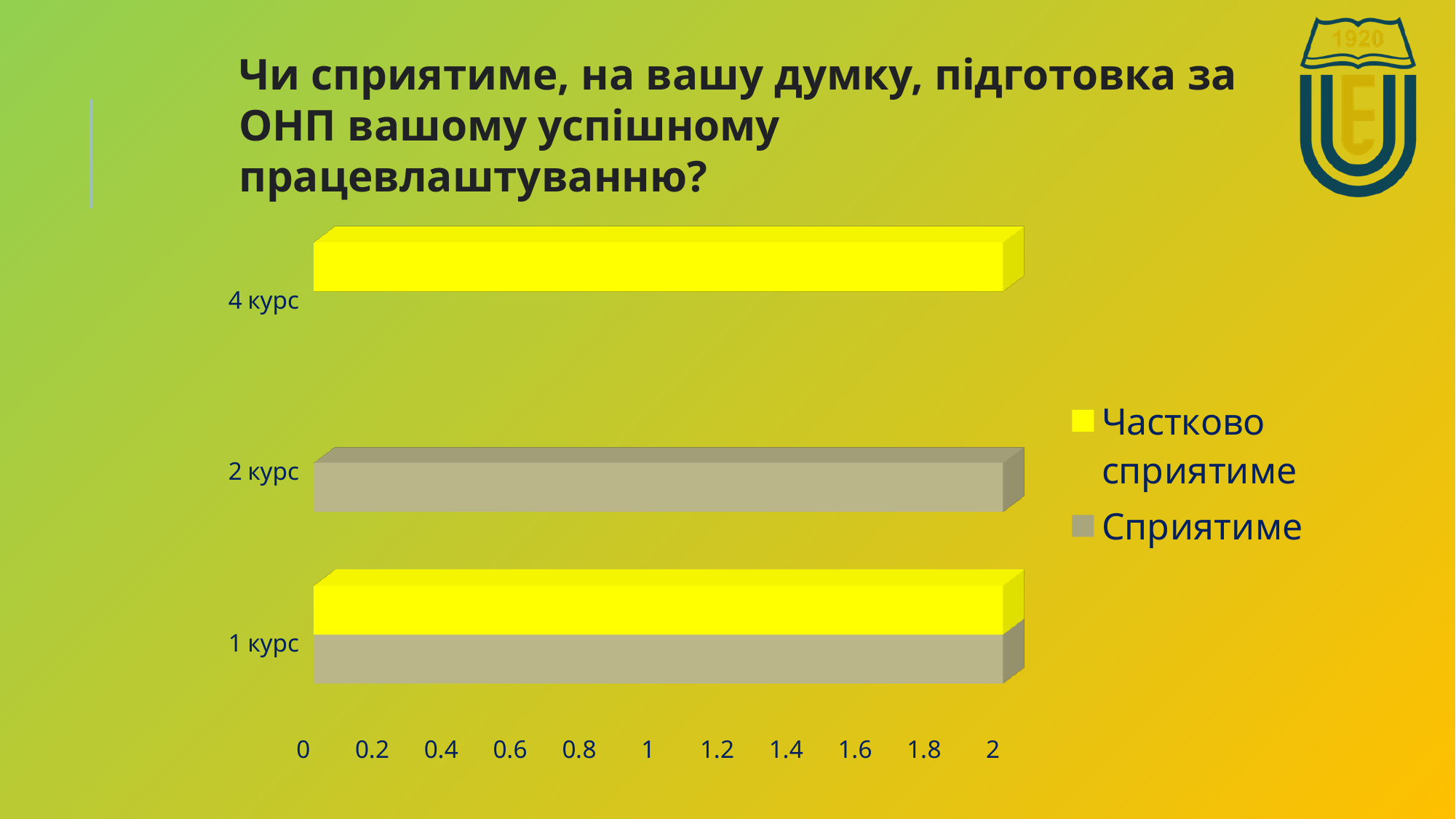
How many series does the chart legend list? 2 Which series is shown in grey in the legend? Сприятиме Which series is shown in yellow in the legend? Частково сприятиме What is the highest value shown on the horizontal axis? 2 What is the value of 'Частково сприятиме' for 4 курс? 2 Is the value of 'Частково сприятиме' for 4 курс greater or less than 1? greater What is the value of 'Сприятиме' for 2 курс? 2 Is the value of 'Сприятиме' for 1 курс greater or less than 1.5? greater What kind of chart is shown on the slide? bar chart How many categories (courses) are shown on the chart? 3 Is the value of 'Сприятиме' for 2 курс greater or less than 1? greater